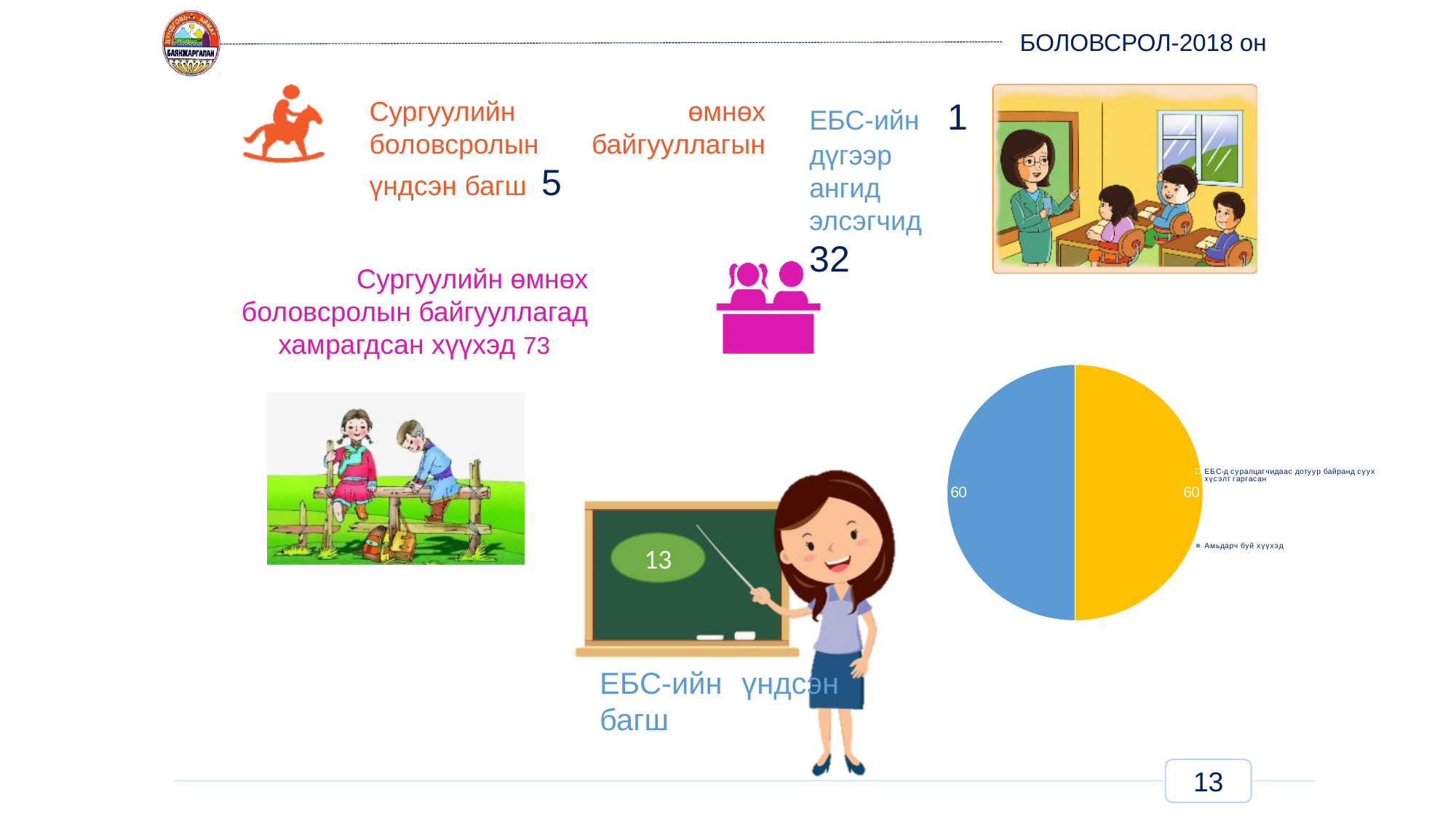
Which colour is used for the "ЕБС-д суралцагчидаас дотуур байранд суух хүсэлт гаргасан" slice in the pie chart? yellow What is the value of the slice labelled "ЕБС-д суралцагчидаас дотуур байранд суух хүсэлт гаргасан" in the pie chart? 60 What share of the pie chart does the "ЕБС-д суралцагчидаас дотуур байранд суух хүсэлт гаргасан" slice represent? 50% What is the difference between the two slice values in the pie chart? 0 How many entries does the pie chart's legend list? 2 What share of the pie chart does the "Амьдарч буй хүүхэд" slice represent? 50% How many slices does the pie chart have? 2 What kind of chart is shown on the slide? pie chart What is the total of the two slice values in the pie chart? 120 What is the value of the slice labelled "Амьдарч буй хүүхэд" in the pie chart? 60 Which colour is used for the "Амьдарч буй хүүхэд" slice in the pie chart? blue